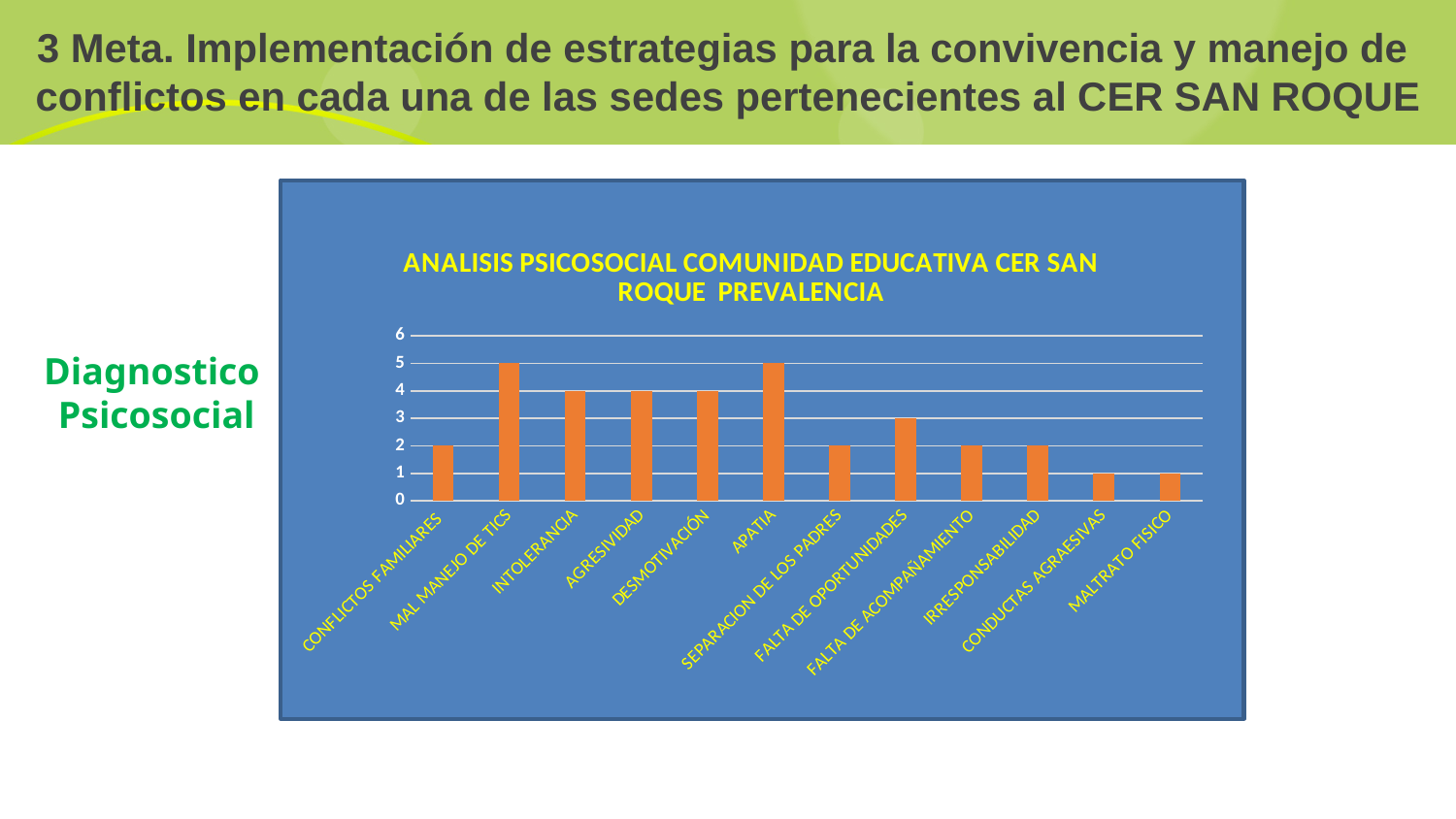
What is the value for CONFLICTOS FAMILIARES? 2 What is the title of the chart? ANALISIS PSICOSOCIAL COMUNIDAD EDUCATIVA CER SAN ROQUE PREVALENCIA What is the value for INTOLERANCIA? 4 What type of chart is shown on the slide? Bar chart What is the value for MALTRATO FISICO? 1 What is the value for FALTA DE OPORTUNIDADES? 3 What is the difference between the value for MAL MANEJO DE TICS and the value for FALTA DE OPORTUNIDADES? 2 Which is larger, the value for APATIA or the value for SEPARACION DE LOS PADRES? APATIA Is the value for DESMOTIVACIÓN greater or less than 3? greater Is the value for CONDUCTAS AGRAESIVAS greater or less than 2? less How many categories are plotted on the x axis of the chart? 12 What is the value for MAL MANEJO DE TICS? 5